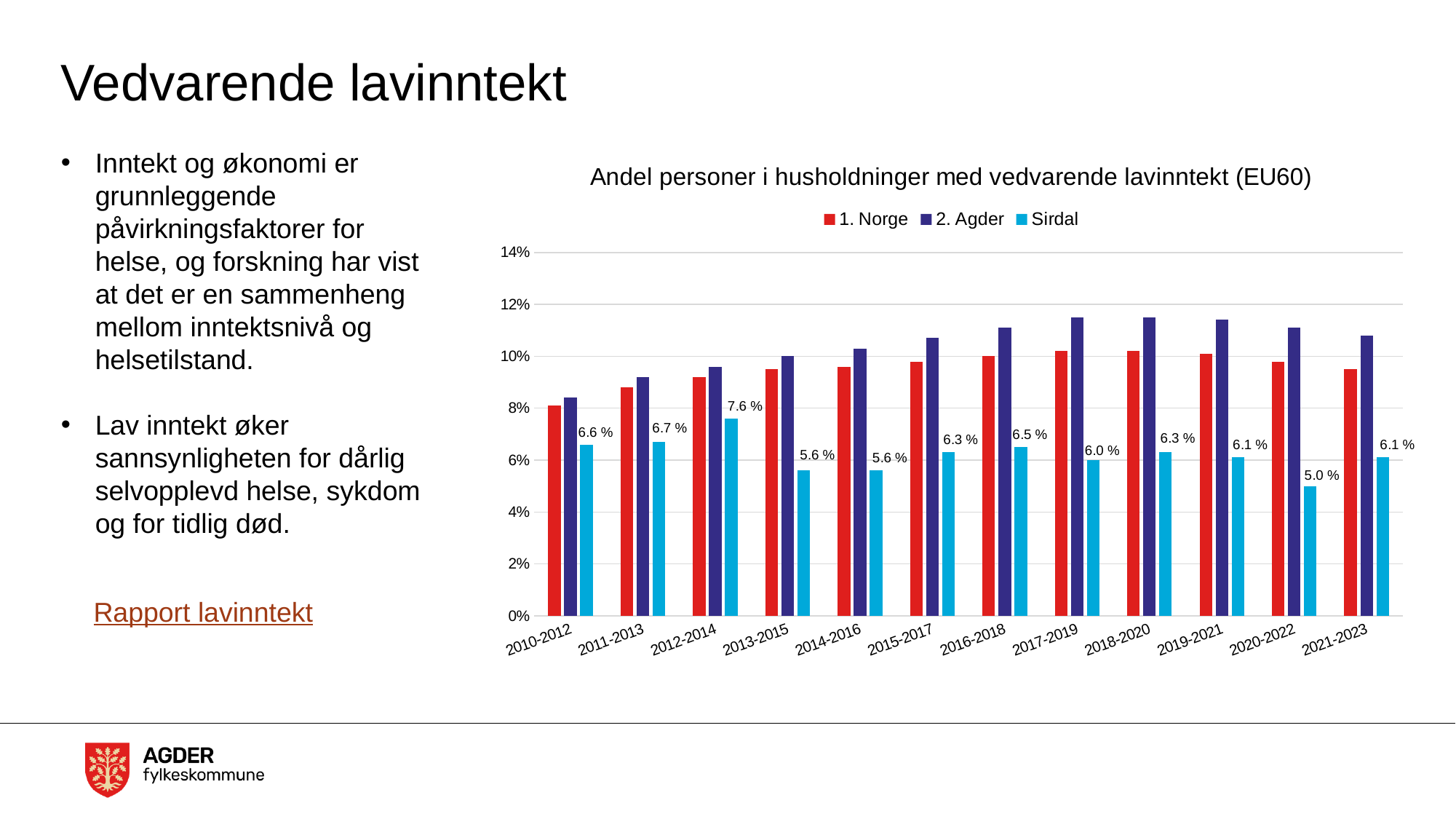
What is the value for Sirdal in 2012-2014? 7.6 % What is the title of the chart? Andel personer i husholdninger med vedvarende lavinntekt (EU60) How many series does the legend list? 3 Is the value for 2. Agder in 2017-2019 greater or less than 10%? greater How many periods are shown along the x axis? 12 What is the difference between the Sirdal values for 2012-2014 and 2020-2022? 2.6 percentage points What is the value for Sirdal in 2020-2022? 5.0 % What is the value for Sirdal in 2021-2023? 6.1 % What kind of chart is shown on the slide? bar chart In which period is the Sirdal value lowest? 2020-2022 In which period is the Sirdal value highest? 2012-2014 In 2017-2019, which is larger: the value for 1. Norge or for 2. Agder? 2. Agder